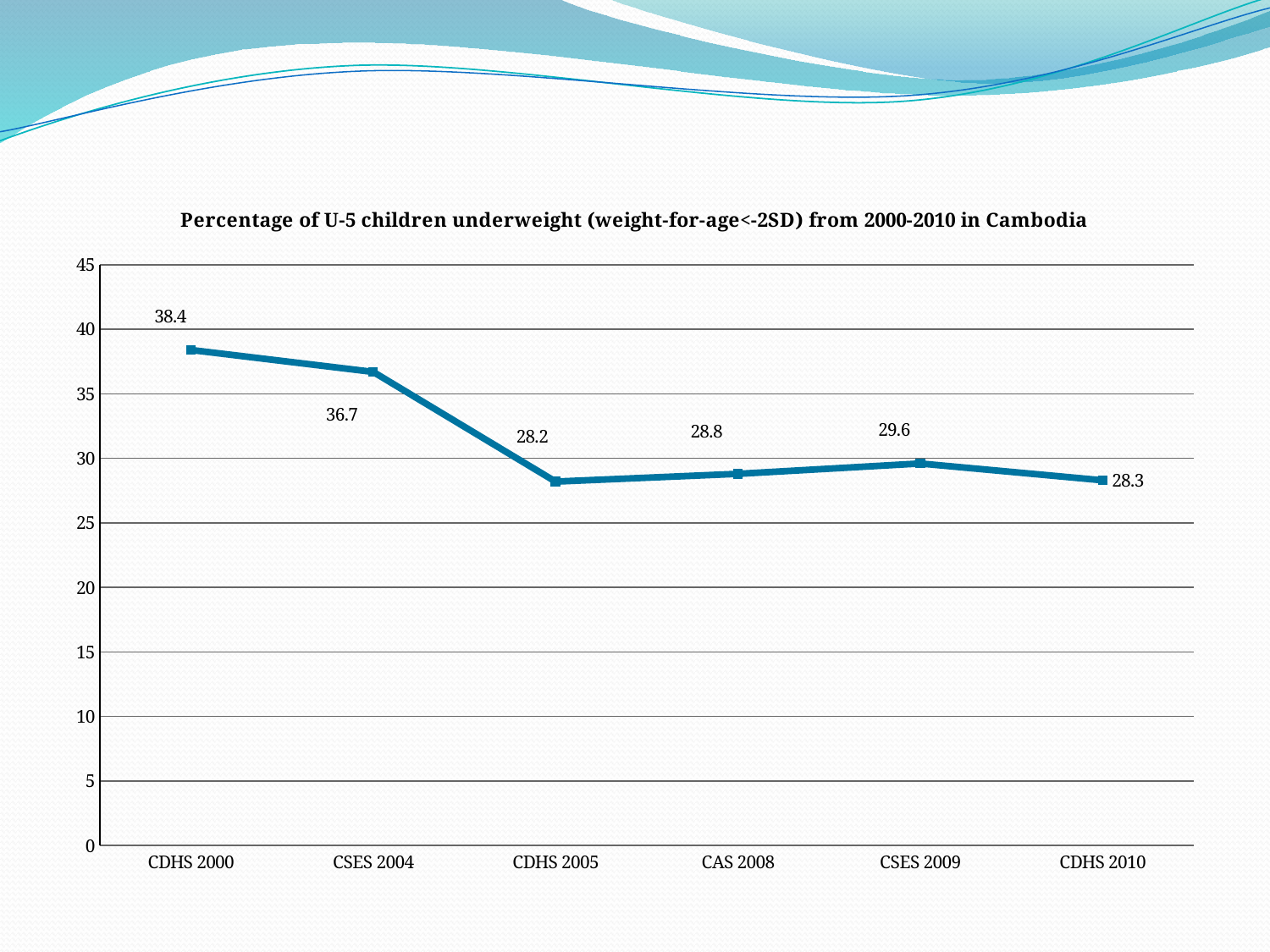
What is the value for CDHS 2000? 38.4 Which is larger, the value for CAS 2008 or the value for CSES 2009? CSES 2009 How many data points are plotted on the chart? 6 What is the value for CDHS 2005? 28.2 Is the value for CSES 2004 greater or less than 35? greater Which survey has the highest percentage of underweight children? CDHS 2000 What is the difference between the values for CDHS 2000 and CDHS 2010? 10.1 What is the value for CSES 2004? 36.7 What kind of chart is shown on the slide? line chart Which survey has the lowest percentage of underweight children? CDHS 2005 What is the value for CSES 2009? 29.6 Does the percentage of underweight children generally rise or fall from CDHS 2000 to CDHS 2010? fall